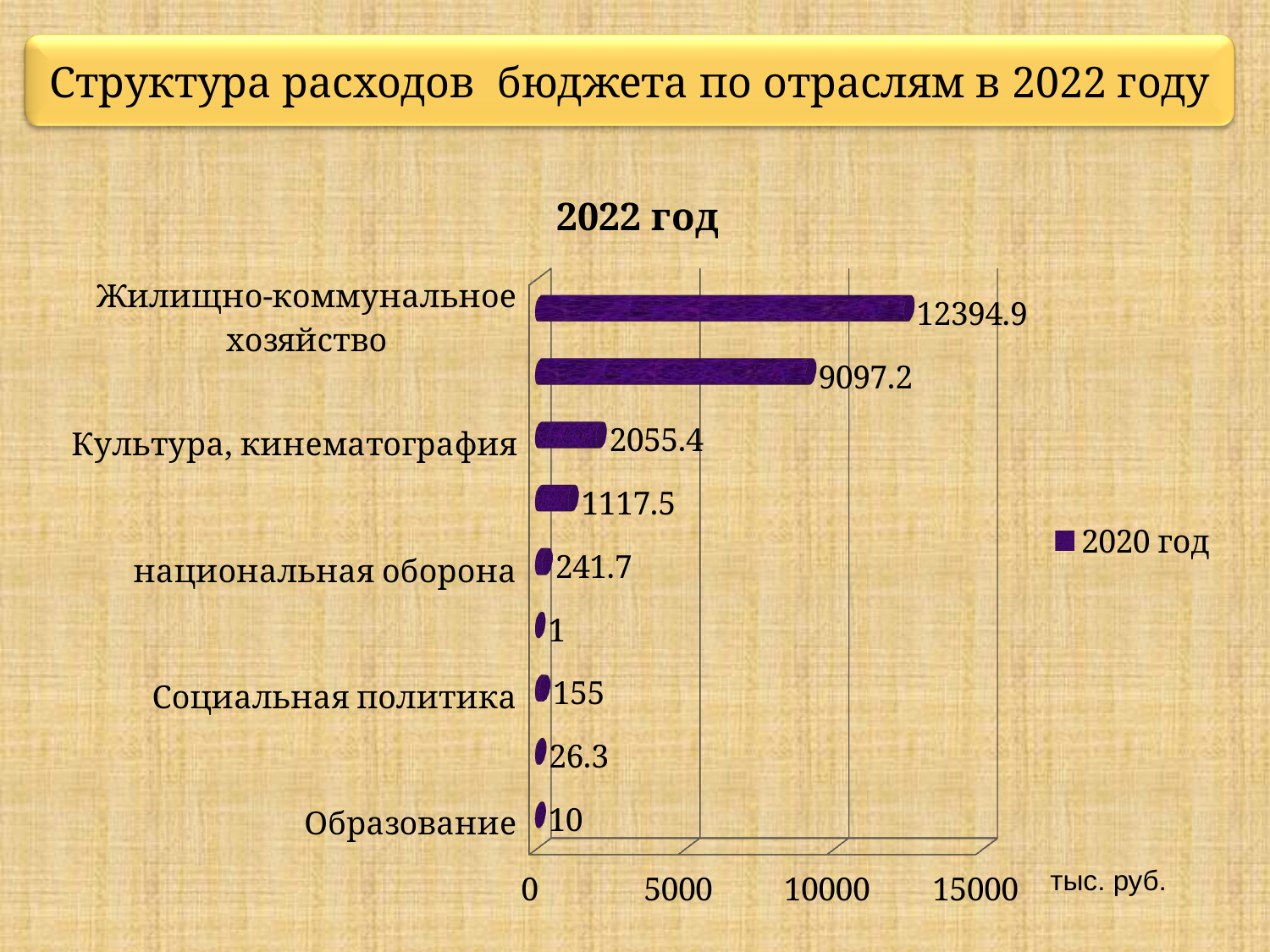
Is the value for Жилищно-коммунальное хозяйство greater or less than 10000? greater What is the value for Жилищно-коммунальное хозяйство? 12394.9 What entry does the legend list? 2020 год Which is larger, the value for Социальная политика or the value for Образование? Социальная политика What is the difference between the values for Жилищно-коммунальное хозяйство and Культура, кинематография? 10339.5 What is the value for Образование? 10 What is the value for Культура, кинематография? 2055.4 What is the value for национальная оборона? 241.7 How many bars are plotted on the chart? 9 What is the value for Социальная политика? 155 What kind of chart is shown? bar chart Which category has the highest value? Жилищно-коммунальное хозяйство